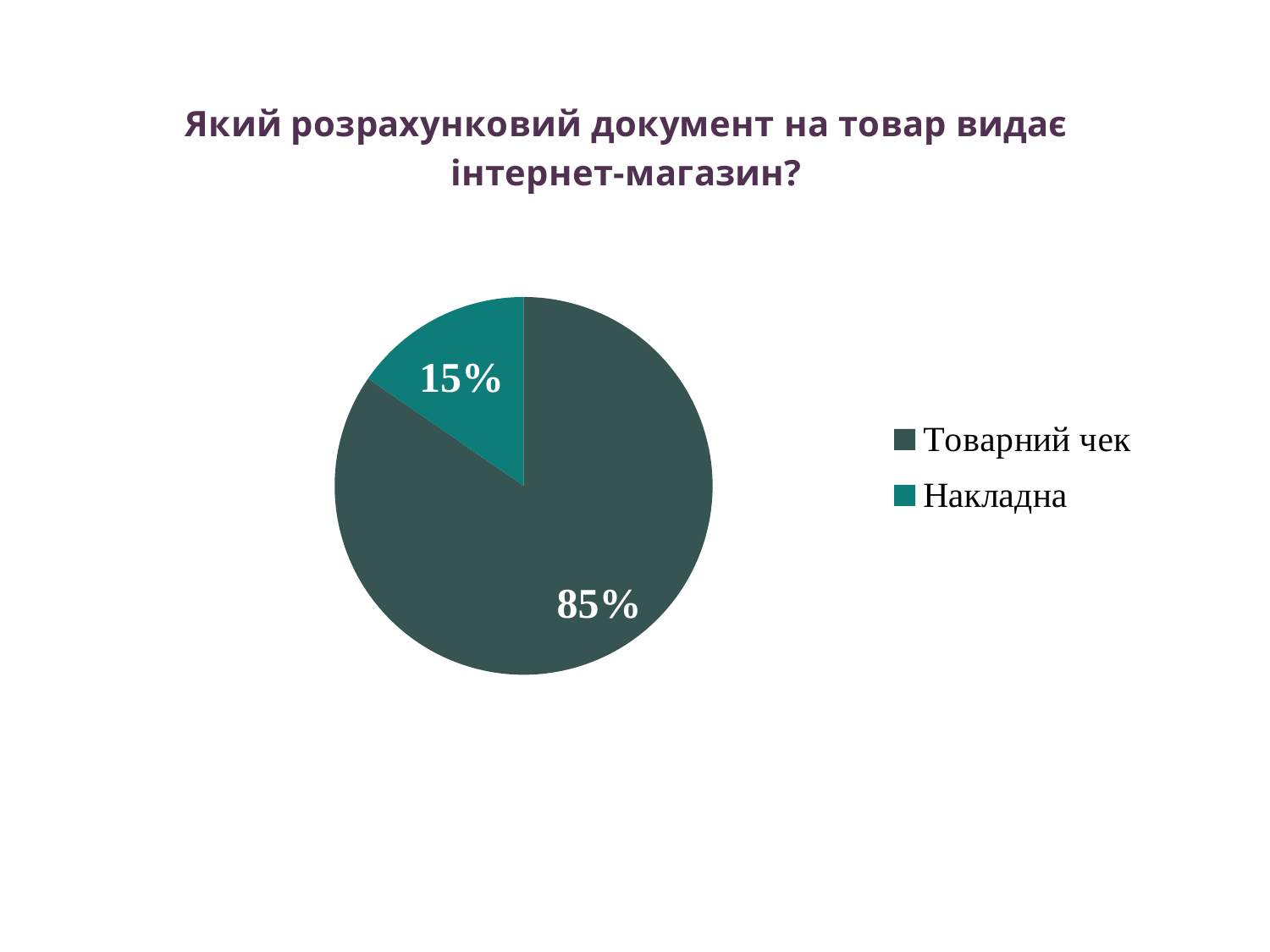
What share of the pie does Накладна have? 15% Which category has the smallest slice of the pie? Накладна What is the title of the chart? Який розрахунковий документ на товар видає інтернет-магазин? Which category has the largest slice of the pie? Товарний чек Which is larger, the share for Товарний чек or the share for Накладна? Товарний чек What kind of chart is shown on the slide? pie chart How many categories does the pie chart show? 2 What is the difference between the shares of Товарний чек and Накладна? 70% Which legend entry is shown in the lighter teal colour? Накладна How many entries does the legend list? 2 What share of the pie does Товарний чек have? 85%